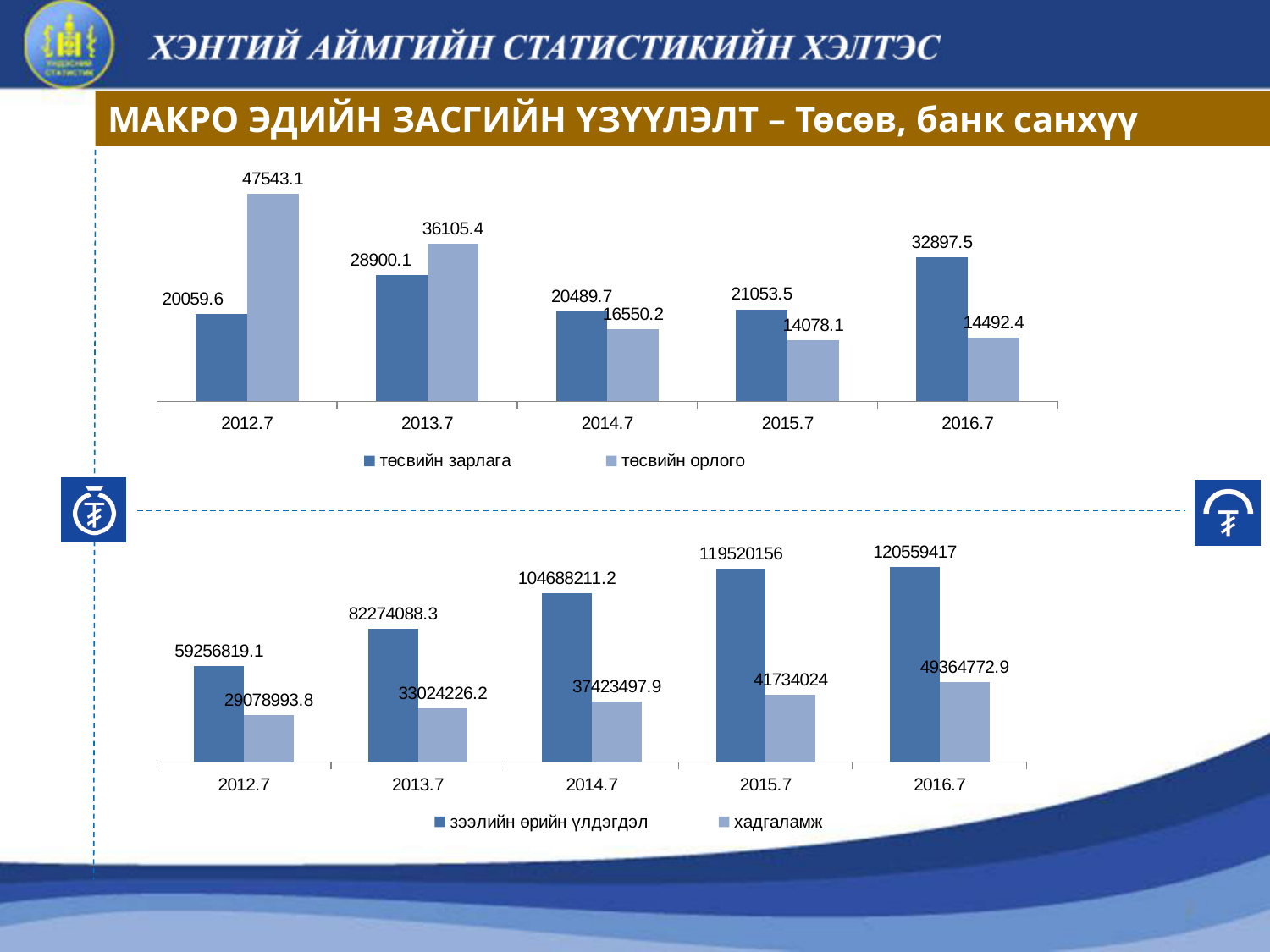
In the bottom chart, what is the difference between хадгаламж in 2016.7 and in 2012.7? 20285779.1 In the top chart, which year has the lowest value for төсвийн орлого? 2015.7 How many series does the legend of the bottom chart list? 2 What type of chart is the top chart? bar chart In the top chart, what is the value of төсвийн зарлага for 2016.7? 32897.5 In the bottom chart, does the value of зээлийн өрийн үлдэгдэл rise or fall from 2012.7 to 2016.7? rise In the top chart, what is the difference between төсвийн орлого and төсвийн зарлага in 2012.7? 27483.5 In the bottom chart, what is the value of хадгаламж for 2015.7? 41734024 In the top chart, which year has the highest value for төсвийн зарлага? 2016.7 In the bottom chart, what is the value of зээлийн өрийн үлдэгдэл for 2014.7? 104688211.2 In the top chart, which is larger in 2014.7: төсвийн зарлага or төсвийн орлого? төсвийн зарлага In the top chart, what is the value of төсвийн орлого for 2012.7? 47543.1